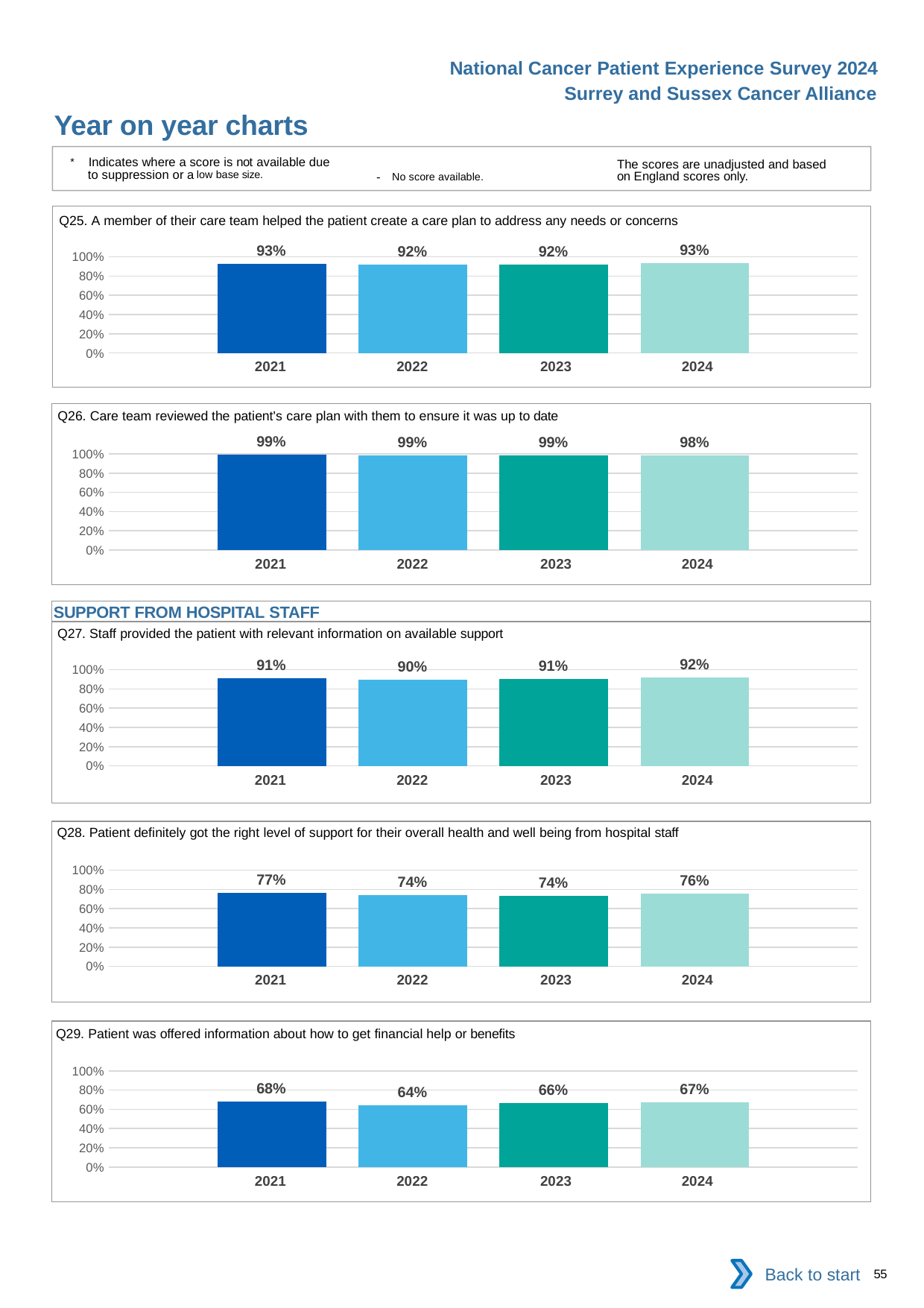
In the Q29 chart, what is the difference between the 2021 and 2022 values? 4% What is the title of the section heading above the Q27 chart? SUPPORT FROM HOSPITAL STAFF In the Q29 chart, which is larger, the value for 2021 or the value for 2022? 2021 In the Q29 chart, is the value for 2024 greater or less than 80%? less In the Q29 chart, what is the value for 2022? 64% In the Q25 chart, what is the value for 2021? 93% In the Q28 chart, which year has the highest value? 2021 What kind of chart is the Q27 chart? bar chart In the Q27 chart, which year has the lowest value? 2022 How many years are shown in the Q25 chart? 4 In the Q28 chart, what is the difference between the 2021 and 2022 values? 3% In the Q26 chart, what is the value for 2024? 98%